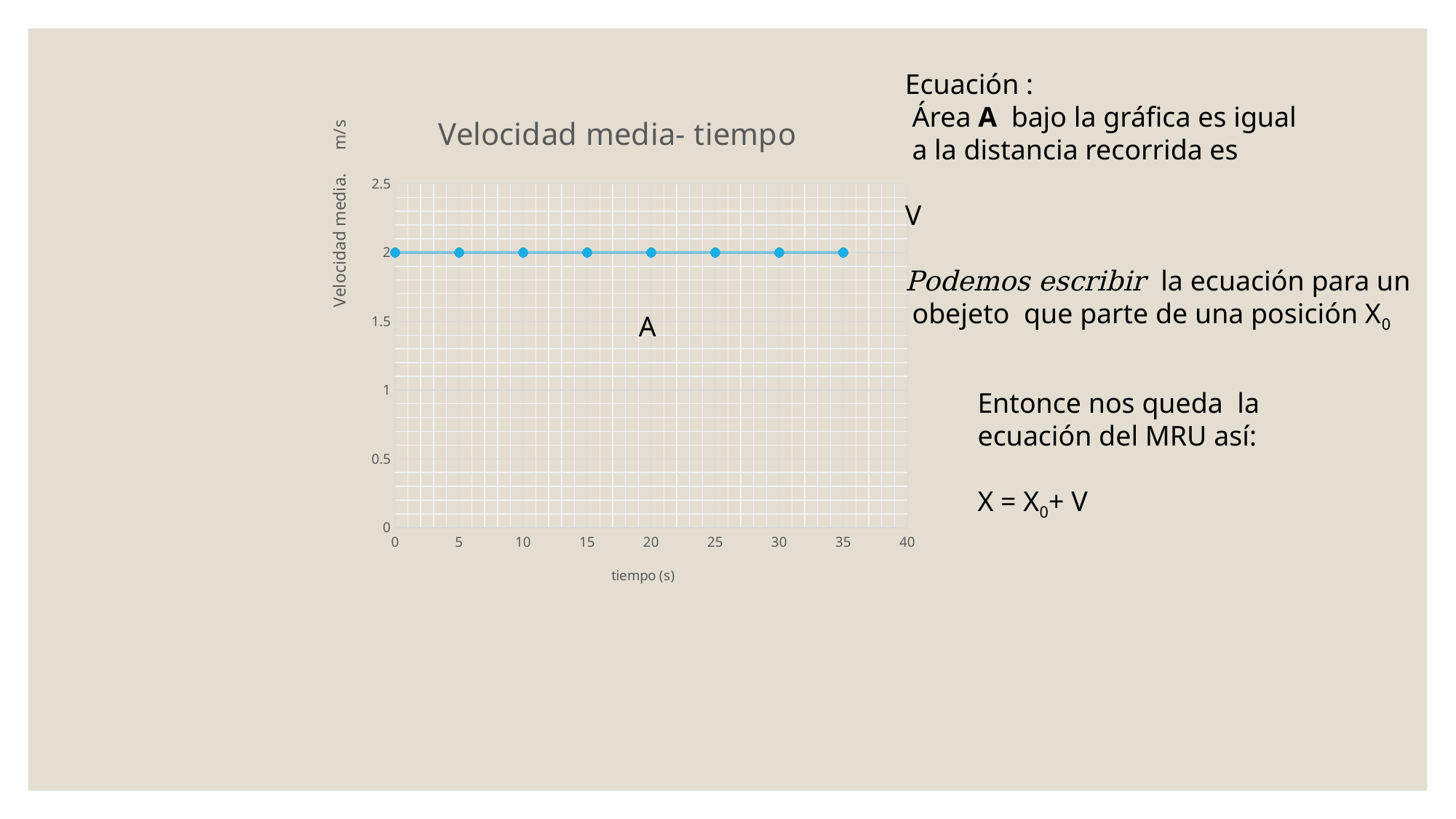
What is the highest tick value shown on the x axis? 40 What kind of chart is shown on the slide? line chart What is the velocidad media value at tiempo 35 s? 2 What is the title of the chart? Velocidad media- tiempo Is the value at tiempo 20 s greater or less than 1.5? greater Do the plotted values rise, fall, or stay constant as tiempo increases from 0 to 35 s? stay constant What is the label of the x axis? tiempo (s) What is the velocidad media value at tiempo 0 s? 2 What is the difference between the value at tiempo 30 s and the value at tiempo 15 s? 0 Is the value at tiempo 5 s greater or less than 2.5? less What is the velocidad media value at tiempo 10 s? 2 How many data points are plotted on the chart? 8